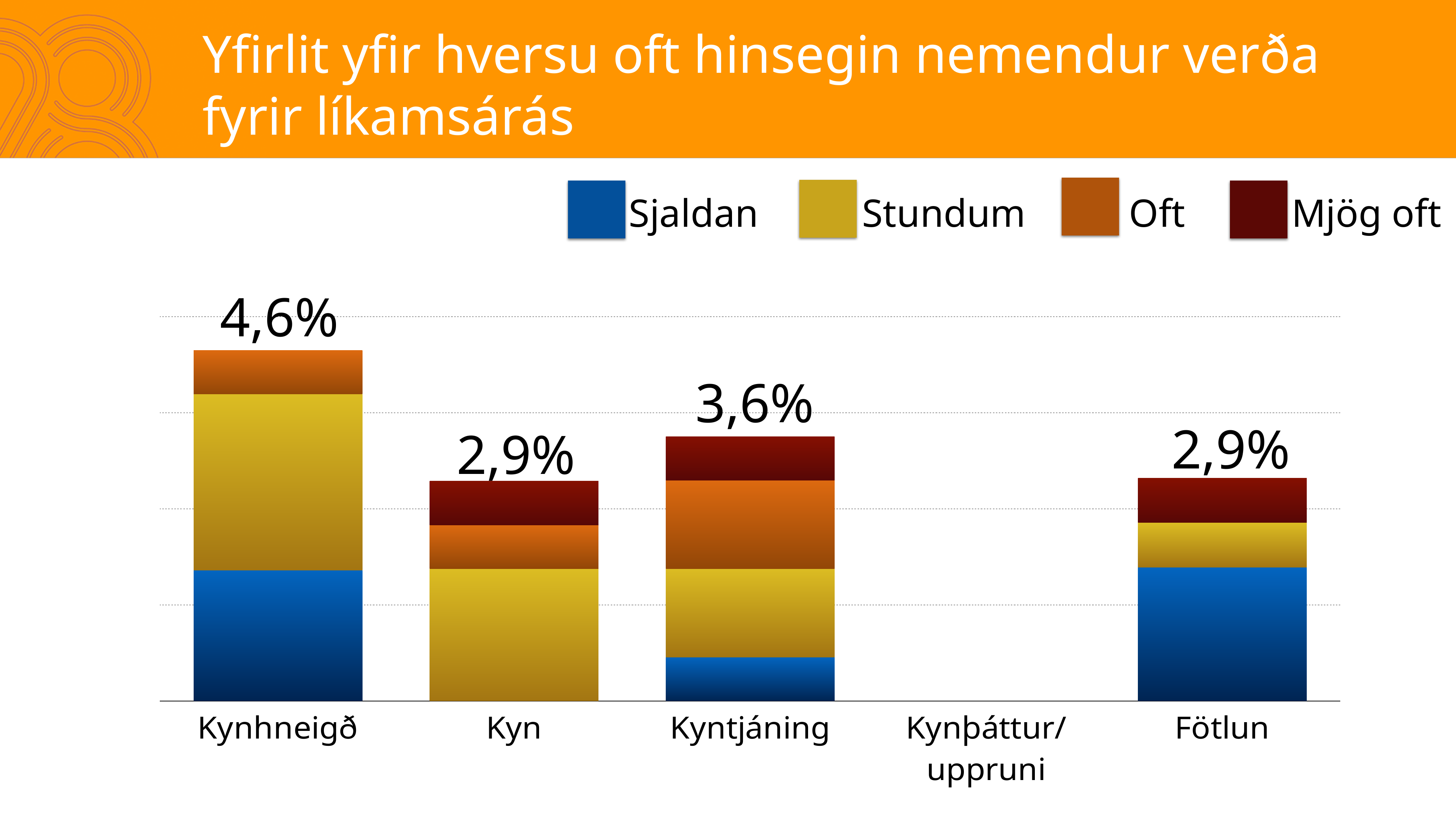
What is the total value shown for Kynhneigð? 4,6% Which has a larger total, Kyntjáning or Kyn? Kyntjáning What kind of chart is shown on the slide? Stacked bar chart How many categories are shown on the x axis? 5 What is the difference between the totals for Kyntjáning and Kyn? 0,7% How many series does the legend list? 4 What is the total value shown for Kyntjáning? 3,6% Which series is shown in blue in the legend? Sjaldan Which category has no bar plotted at all? Kynþáttur/uppruni What is the total value shown for Fötlun? 2,9% Which category has the highest total? Kynhneigð What is the difference between the totals for Kynhneigð and Kyntjáning? 1,0%